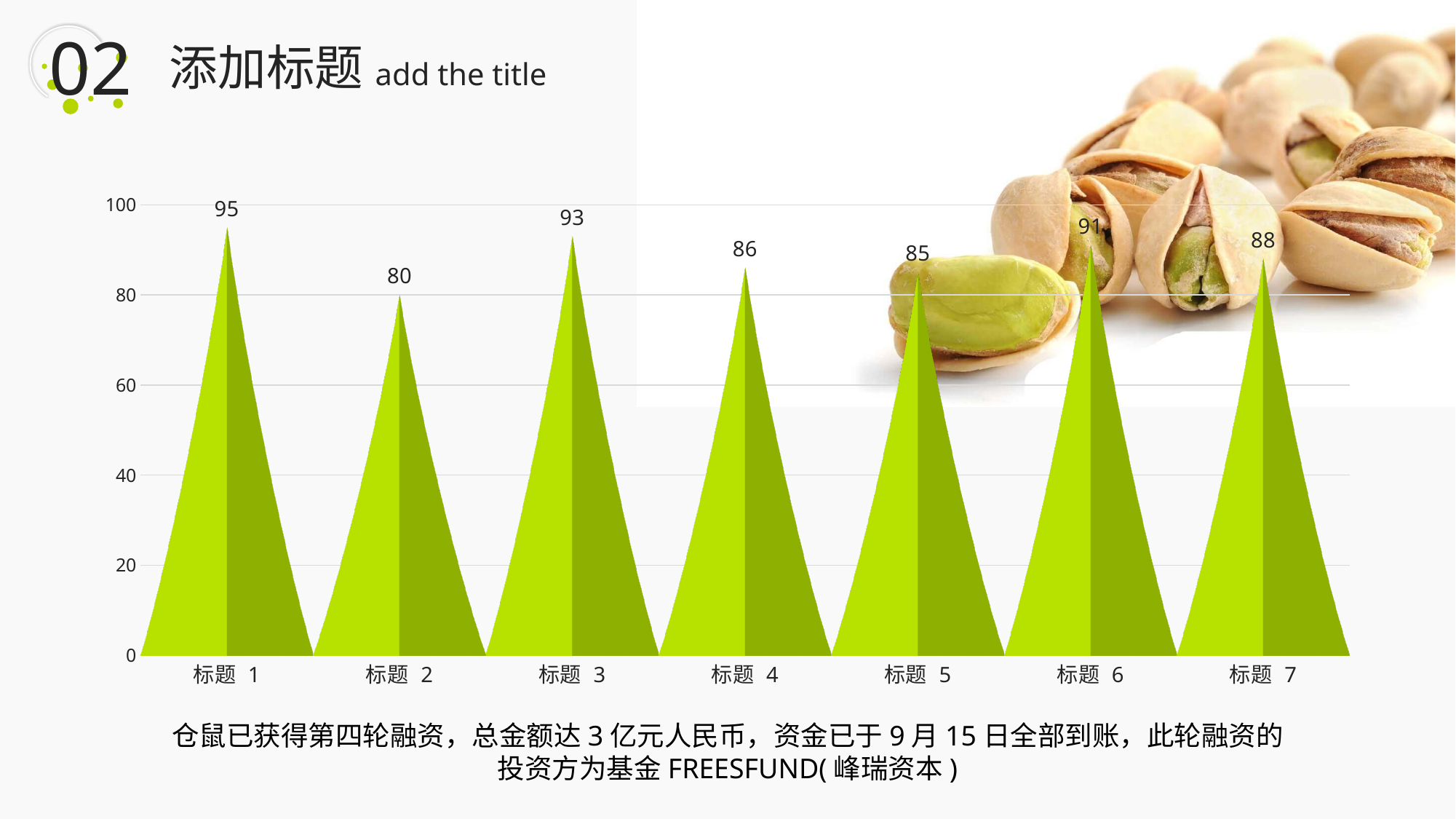
What is the difference between the values for 标题 1 and 标题 2? 15 Which category has the highest value? 标题 1 Which category has the lowest value? 标题 2 Is the value for 标题 5 greater or less than 80? greater What is the highest value shown on the vertical axis? 100 What kind of chart is shown on the slide? bar chart What is the value for 标题 4? 86 Which is larger, the value for 标题 4 or the value for 标题 6? 标题 6 What is the value for 标题 1? 95 How many categories are shown on the x axis? 7 What is the value for 标题 7? 88 What is the difference between the values for 标题 3 and 标题 6? 2